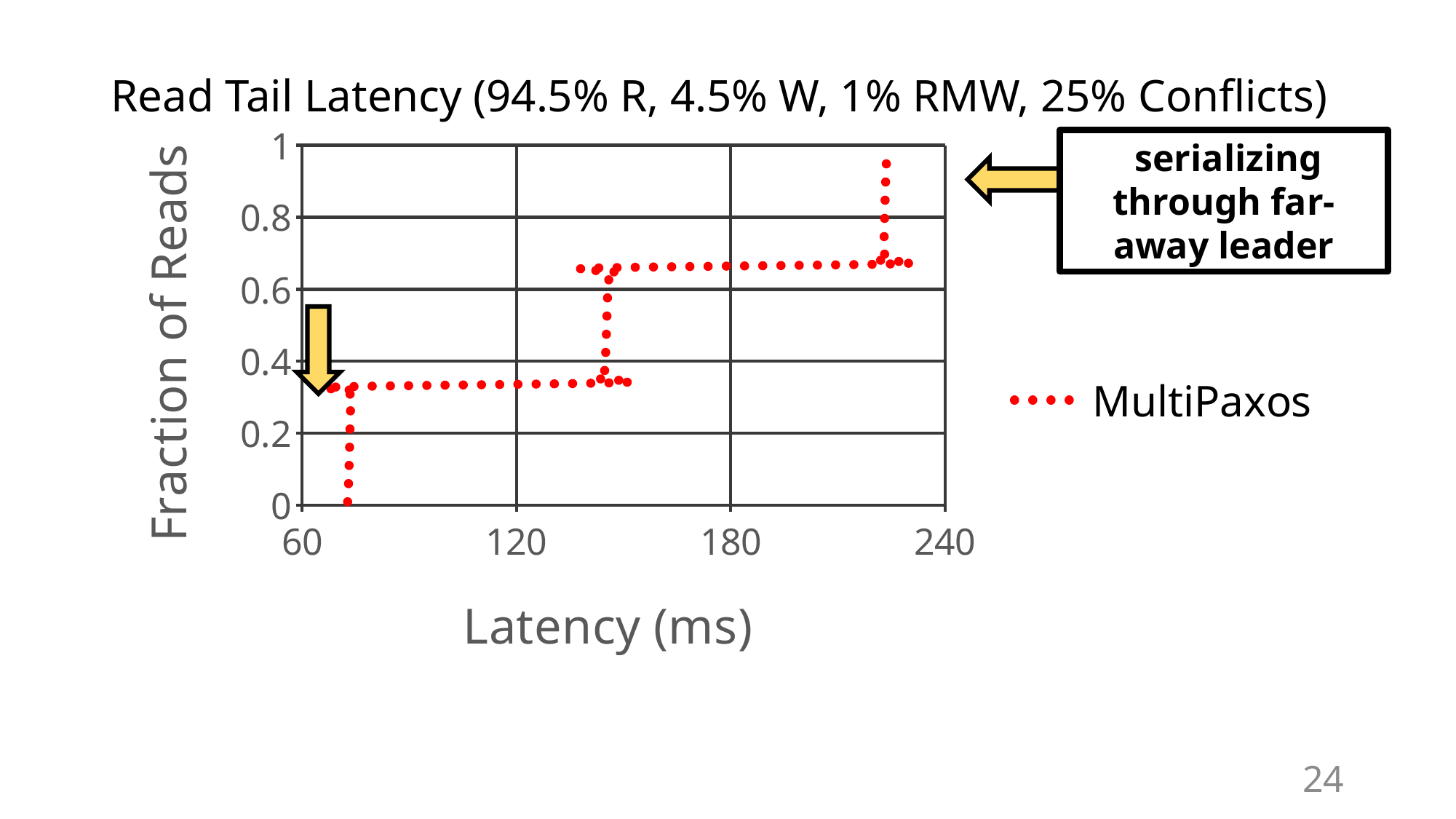
What is the label of the x axis? Latency (ms) Is the fraction of reads for MultiPaxos at a latency of 200 ms greater or less than 0.8? less Is the fraction of reads for MultiPaxos at a latency of 180 ms greater or less than 0.6? greater Is the fraction of reads for MultiPaxos at a latency of 120 ms greater or less than 0.4? less What is the title of the chart? Read Tail Latency (94.5% R, 4.5% W, 1% RMW, 25% Conflicts) What is the lowest value shown on the x axis? 60 What is the label of the y axis? Fraction of Reads What series is shown in the legend? MultiPaxos What is the highest value shown on the x axis? 240 Does the fraction of reads rise or fall as latency increases along the x axis? rise How many series does the legend list? 1